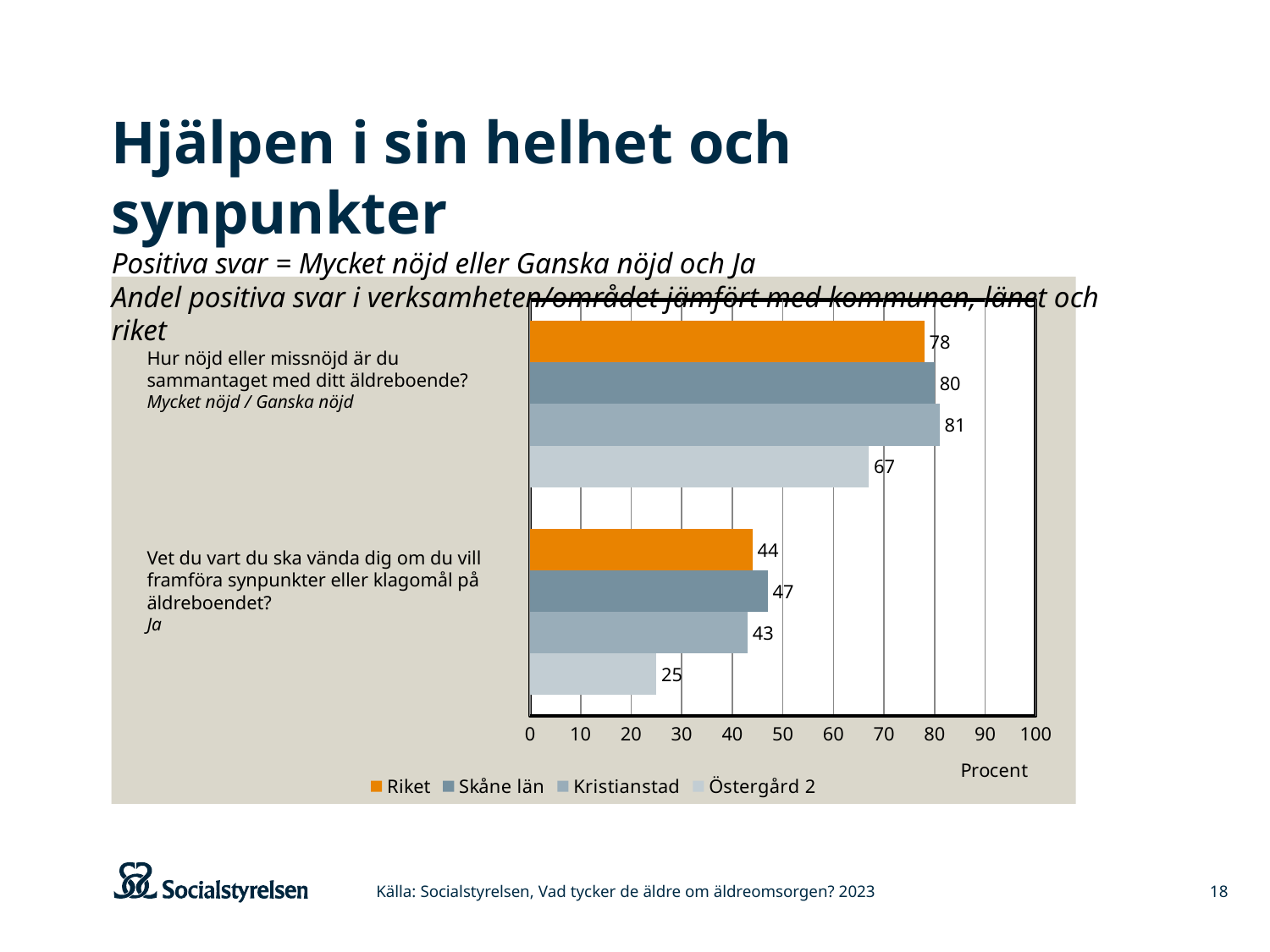
What is the value for Kristianstad on the question about overall satisfaction with the elderly housing? 81 What is the difference between Kristianstad and Östergård 2 on the question about overall satisfaction with the elderly housing? 14 What unit is shown on the x axis of the chart? Procent What is the value for Östergård 2 on the question about whether you know where to turn to give feedback or complaints (Vet du vart du ska vända dig...)? 25 What is the value for Riket on the question about how satisfied you are overall with your elderly housing (Hur nöjd eller missnöjd är du sammantaget med ditt äldreboende)? 78 Which is larger on the question about knowing where to turn with feedback or complaints: Riket or Östergård 2? Riket What type of chart is shown on the slide? bar chart Which series has the lowest value on the question about overall satisfaction with the elderly housing? Östergård 2 How many question categories are shown on the chart? 2 How many series does the legend list? 4 Which series has the highest value on the question about knowing where to turn with feedback or complaints? Skåne län What is the value for Skåne län on the question about knowing where to turn with feedback or complaints? 47